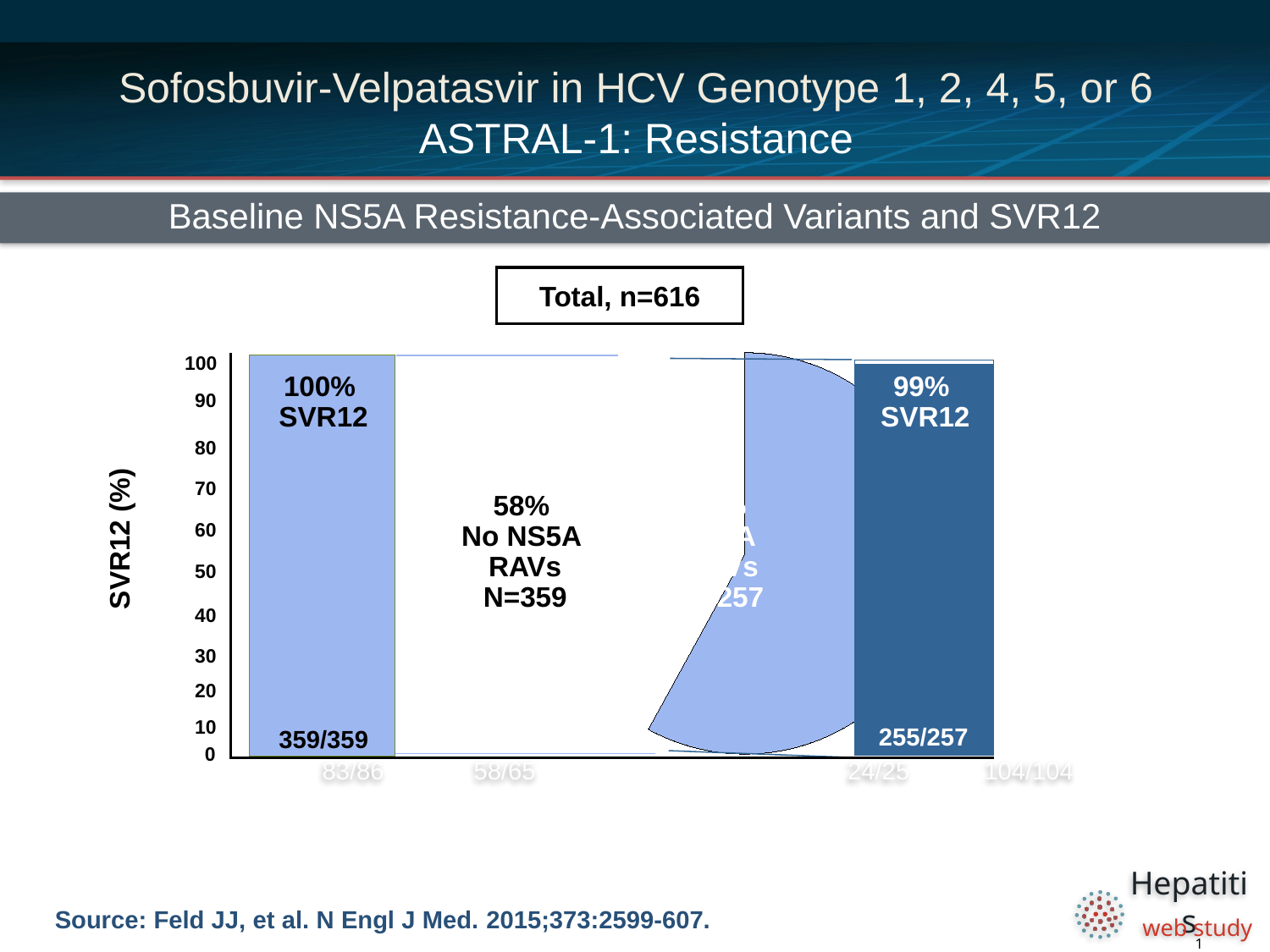
What is the difference in SVR12 rate between the left bar (100%) and the right bar (99%)? 1 percentage point What kind of chart is the main chart on the slide? bar chart What percentage of patients had no NS5A RAVs according to the pie overlay? 58% What patient fraction is printed at the bottom of the left bar? 359/359 What patient fraction is printed at the bottom of the right bar? 255/257 What SVR12 rate is printed on the right (dark blue) bar of the chart? 99% What SVR12 rate is printed on the left (light blue) bar of the chart? 100% Which bar shows the higher SVR12 rate, the left bar or the right bar? the left bar (100%) What total number of patients (n) is shown in the box above the chart? 616 What is the N for the 'No NS5A RAVs' group shown in the pie overlay? 359 Is the SVR12 value for the right (dark blue) bar greater or less than 90? greater What is the label on the y-axis of the chart? SVR12 (%)